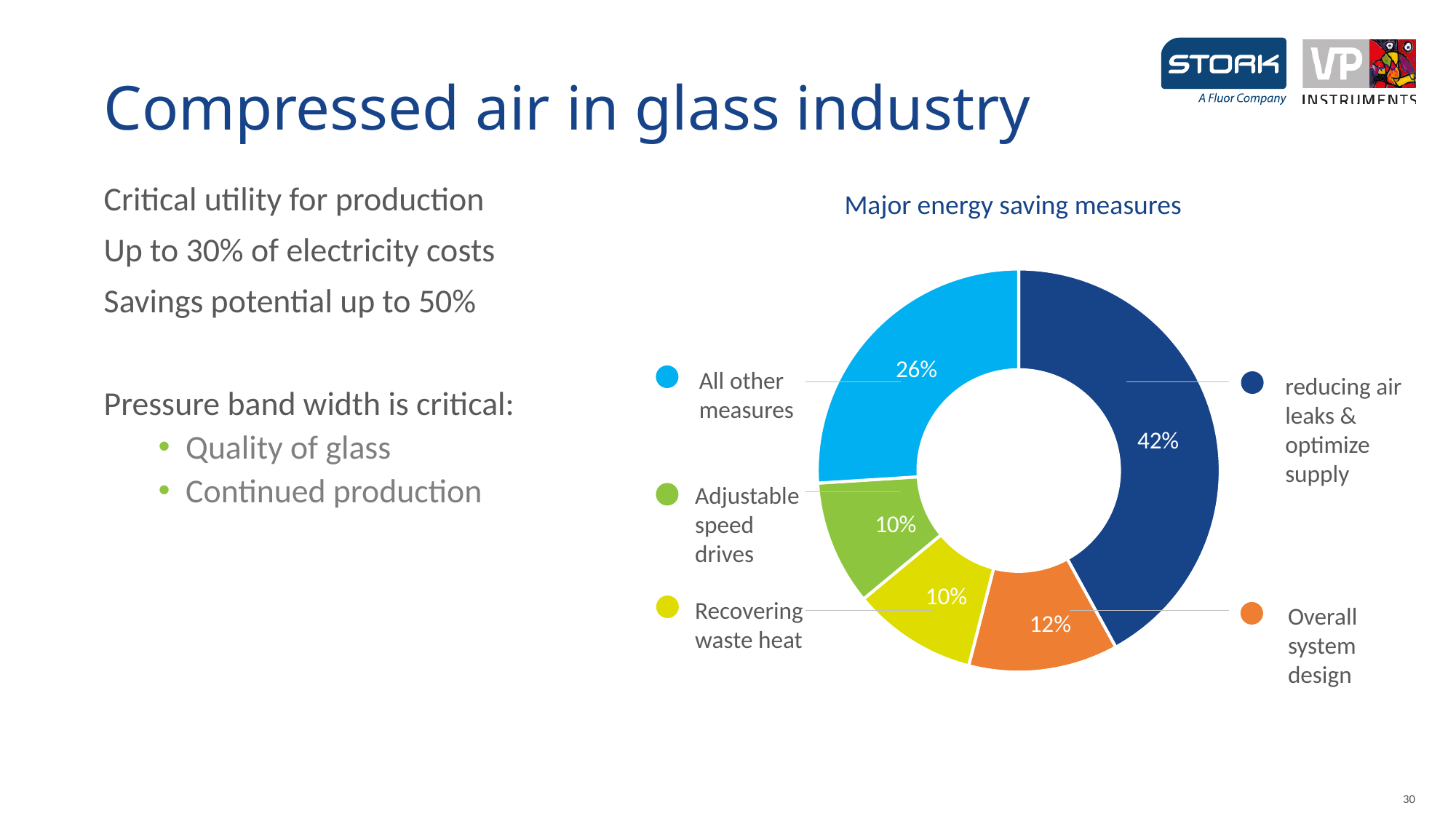
What percentage is shown for 'Adjustable speed drives'? 10% Which is larger: the share for 'Overall system design' or the share for 'Recovering waste heat'? Overall system design What percentage is shown for 'Overall system design'? 12% What share of the chart does 'reducing air leaks & optimize supply' account for? 42% What is the combined share of 'Adjustable speed drives' and 'Recovering waste heat'? 20% What is the title of the chart? Major energy saving measures What percentage is shown for 'All other measures'? 26% What is the difference in percentage points between 'reducing air leaks & optimize supply' and 'All other measures'? 16 What kind of chart is shown on the slide? Doughnut (pie) chart What colour is the segment for 'Overall system design'? Orange Which measure has the largest share of the chart? reducing air leaks & optimize supply How many categories are shown in the chart? 5